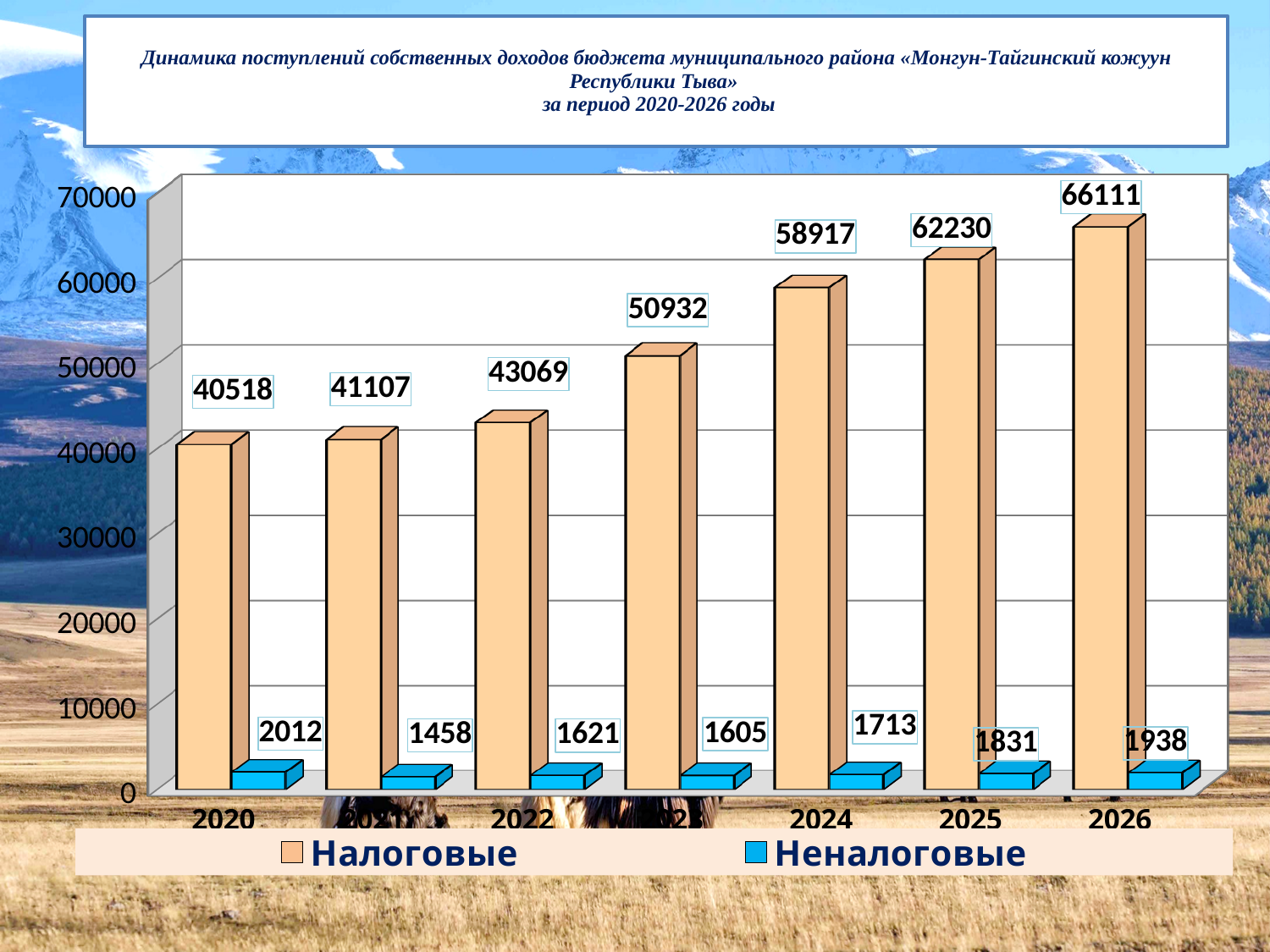
What is the value for Неналоговые in 2020? 2012 How many years are shown on the x axis? 7 What kind of chart is shown on the slide? bar chart In which year is the Неналоговые value lowest? 2021 What is the value for Налоговые in 2024? 58917 Is the Налоговые value for 2022 greater or less than 50000? less In which year is the Налоговые value highest? 2026 How many series does the legend list? 2 Which is larger, the Неналоговые value for 2020 or for 2026? 2020 What is the value for Неналоговые in 2025? 1831 What is the value for Налоговые in 2026? 66111 What is the difference between the Налоговые values for 2026 and 2020? 25593